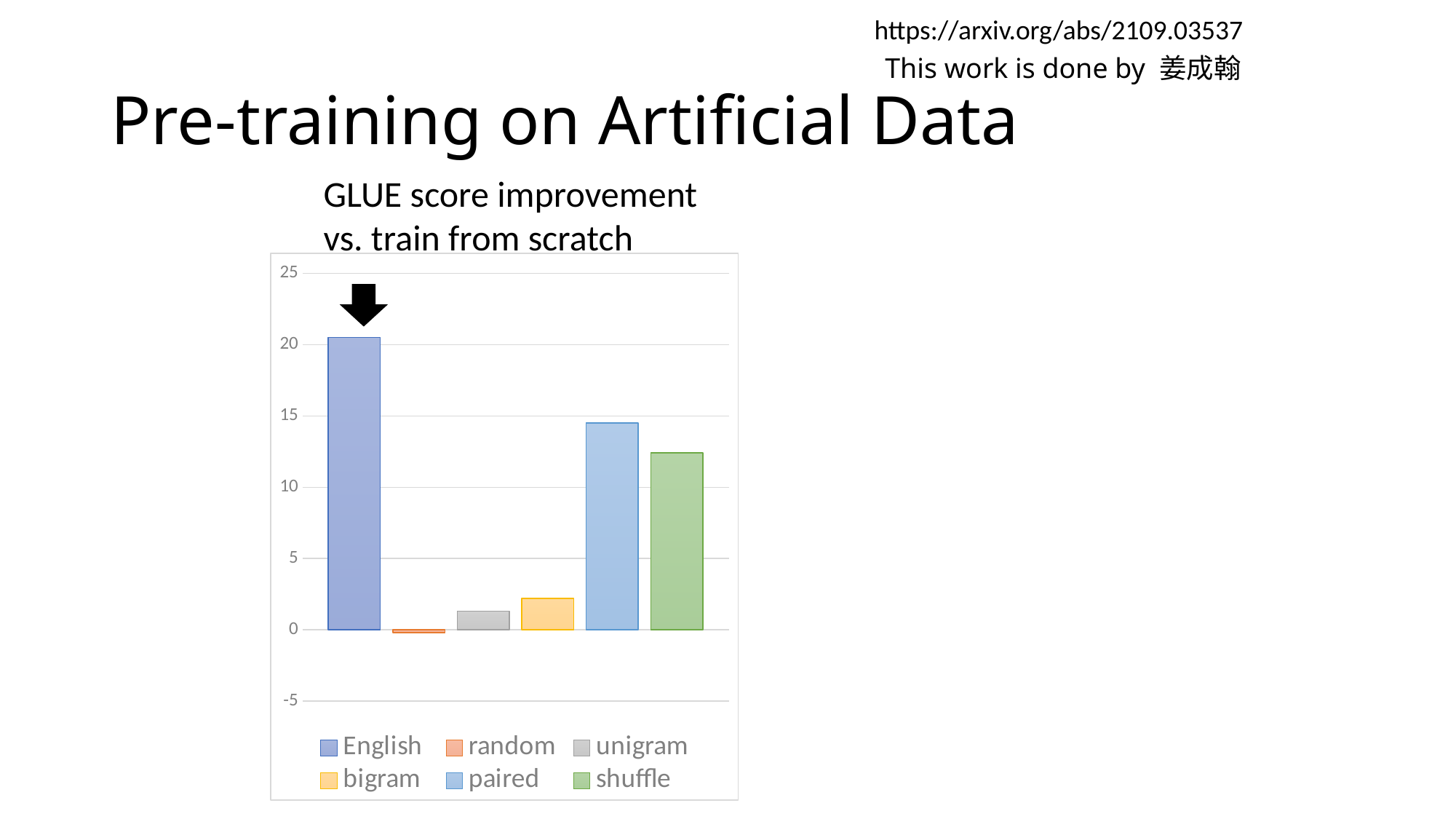
Is the value for random greater or less than 0? less What is the title of the chart? GLUE score improvement vs. train from scratch Which series has the highest GLUE score improvement? English How many series does the legend list? 6 What kind of chart is shown on the slide? bar chart Is the value for paired greater or less than 15? less Which series has the lowest GLUE score improvement? random Which is larger, the value for bigram or the value for unigram? bigram Which is larger, the value for paired or the value for shuffle? paired Is the value for English greater or less than 20? greater How many bars are plotted in the chart? 6